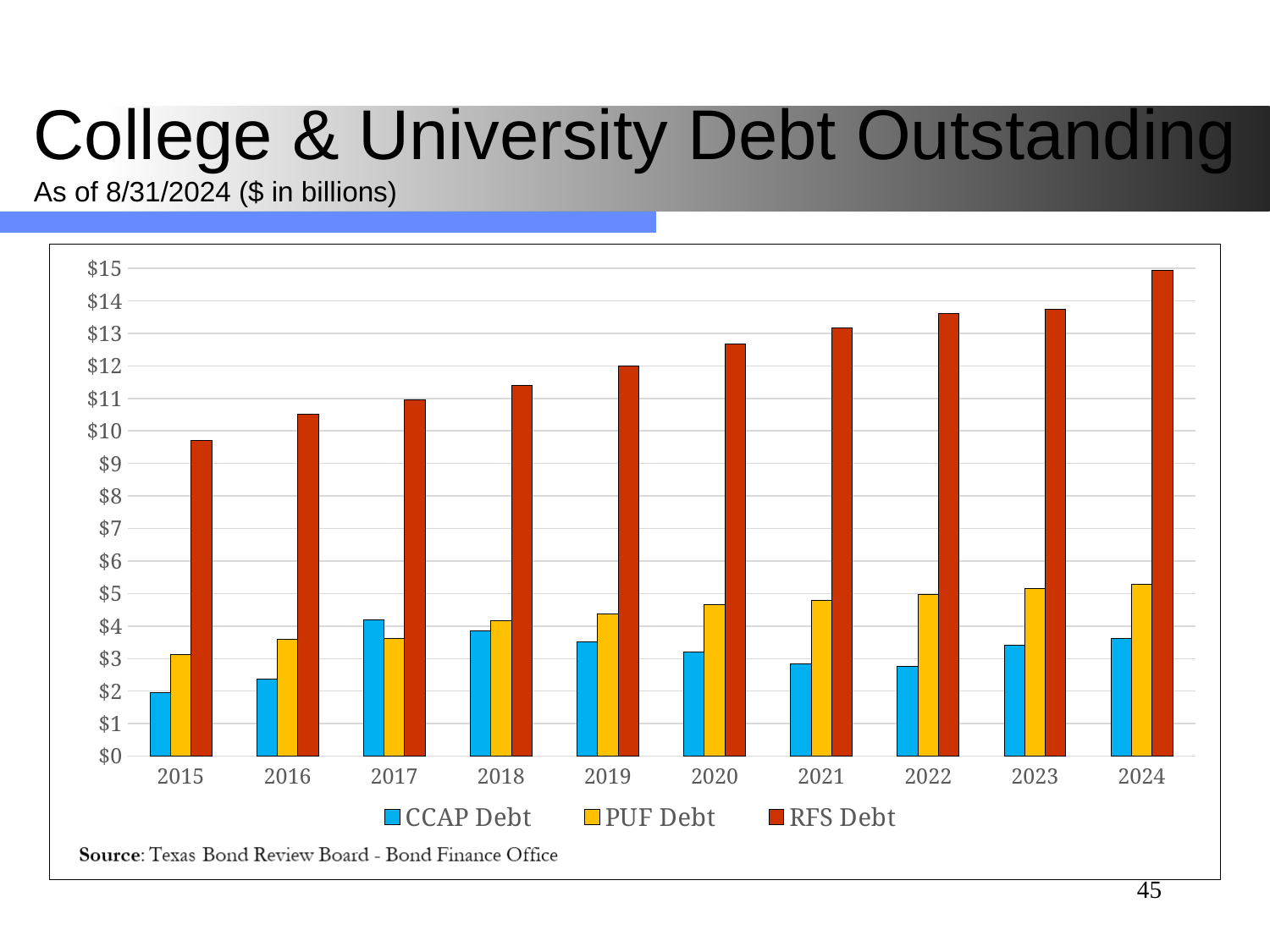
In 2024, which is larger: PUF Debt or CCAP Debt? PUF Debt Is the value for RFS Debt in 2015 greater or less than $10? less In which year is RFS Debt highest? 2024 Which series is shown in red? RFS Debt In which year is CCAP Debt highest? 2017 How many series does the legend list? 3 What kind of chart is shown on the slide? bar chart In which year is CCAP Debt lowest? 2015 In 2017, which is larger: CCAP Debt or PUF Debt? CCAP Debt Is the value for RFS Debt in 2024 greater or less than $14? greater Does RFS Debt rise or fall from 2015 to 2024? rise How many years are shown on the x axis? 10